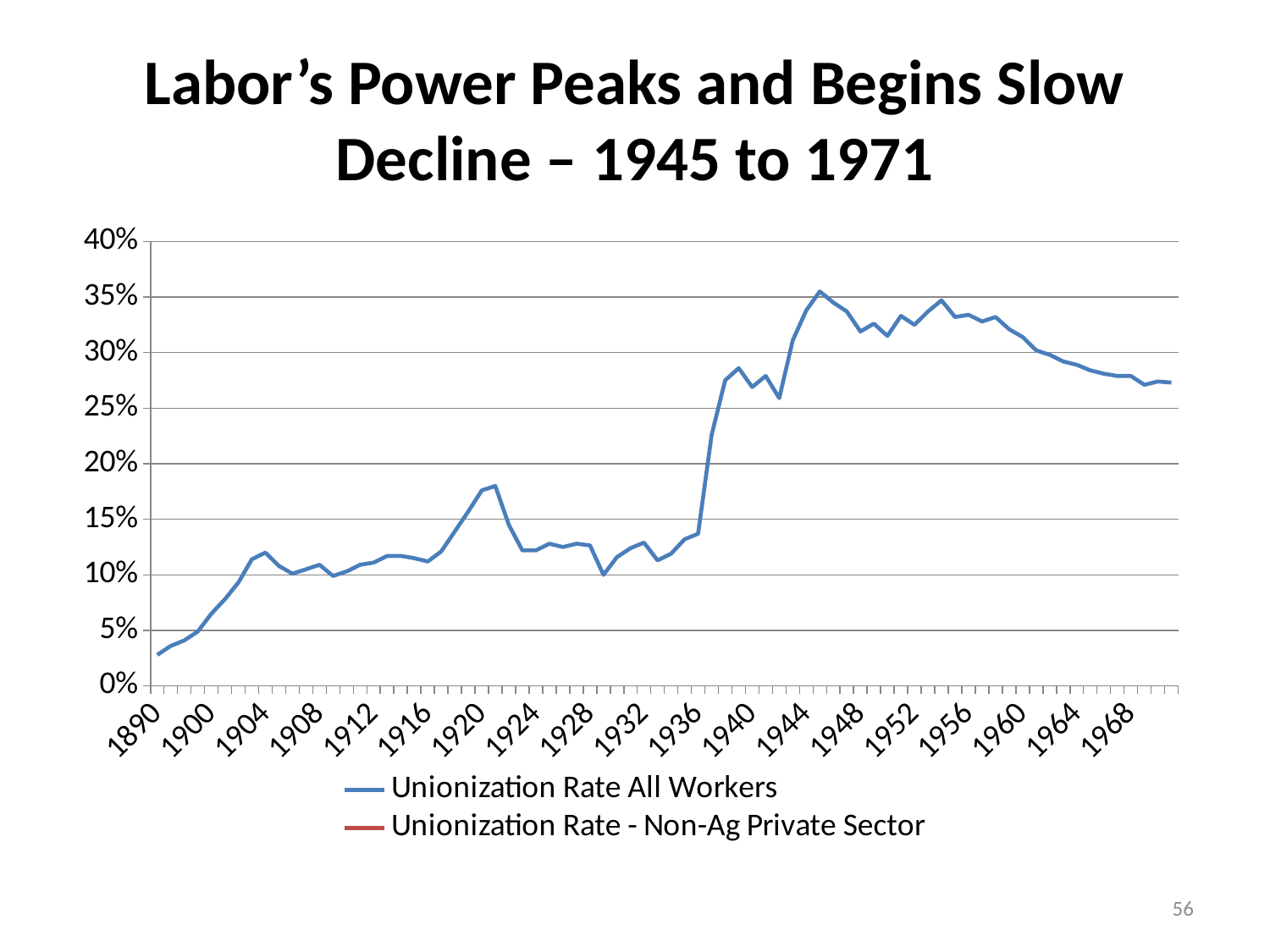
What is the title of the slide's chart? Labor's Power Peaks and Begins Slow Decline – 1945 to 1971 Is the Unionization Rate All Workers value for 1968 greater or less than 30%? less How many series does the legend list? 2 Which is larger, the Unionization Rate All Workers value for 1944 or for 1928? 1944 Is the Unionization Rate All Workers value for 1904 greater or less than 10%? greater Does the Unionization Rate All Workers line rise or fall between 1960 and 1968? fall Is the Unionization Rate All Workers value for 1940 greater or less than 25%? greater What kind of chart is shown on the slide? line chart What colour is the line for Unionization Rate All Workers? blue Which year has the lowest Unionization Rate All Workers value? 1890